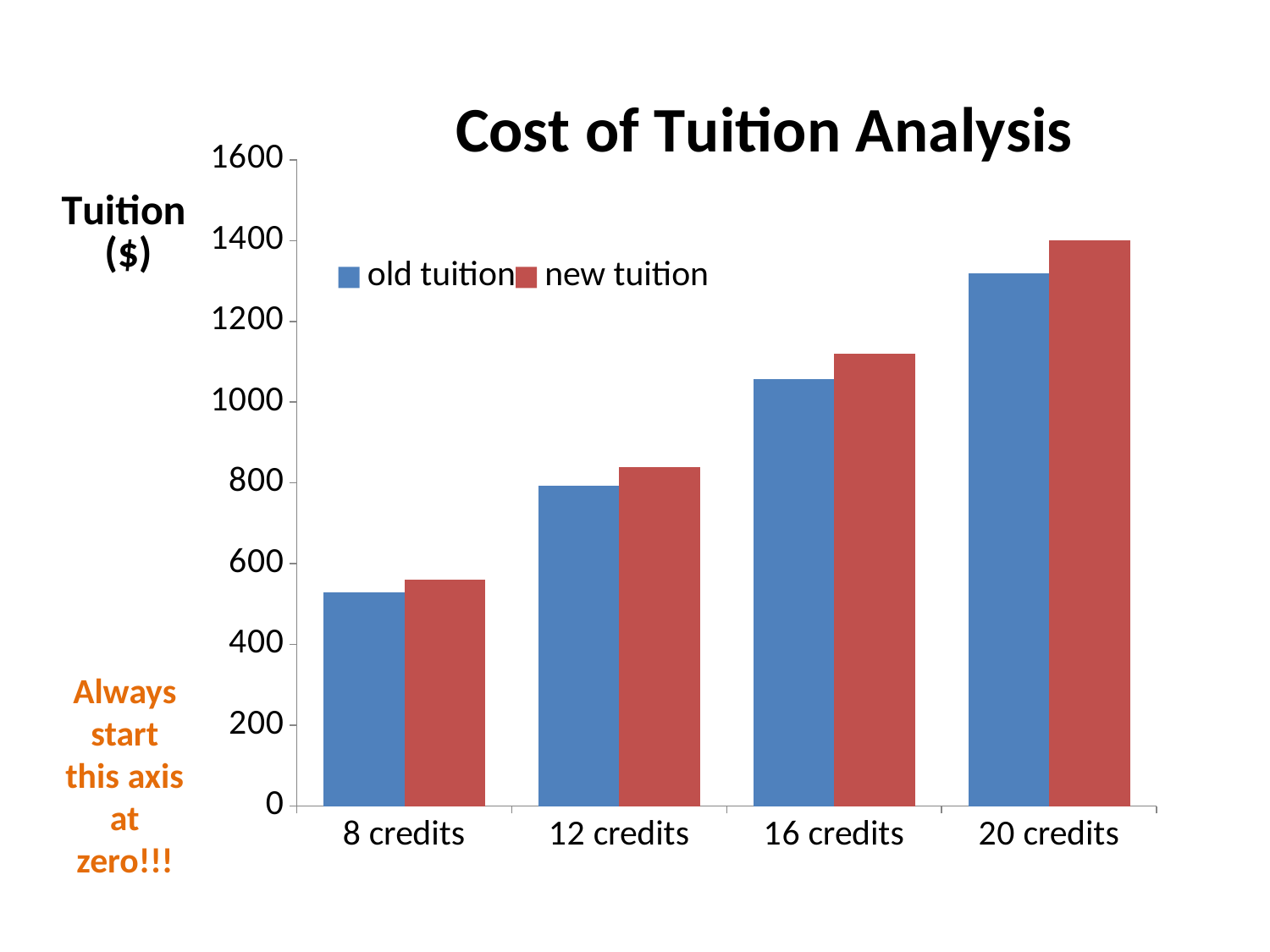
Which credit category has the highest new tuition? 20 credits Is the new tuition for 16 credits greater or less than 1000? greater Which is larger for 12 credits, old tuition or new tuition? new tuition What is the title of the chart? Cost of Tuition Analysis Is the old tuition for 20 credits greater or less than 1200? greater Is the old tuition for 8 credits greater or less than 600? less How many credit categories are shown on the x axis? 4 How many series does the legend list? 2 Which credit category has the lowest old tuition? 8 credits What is the label on the vertical axis? Tuition ($) What type of chart is shown on the slide? bar chart Do the old tuition values rise or fall as the number of credits increases? rise